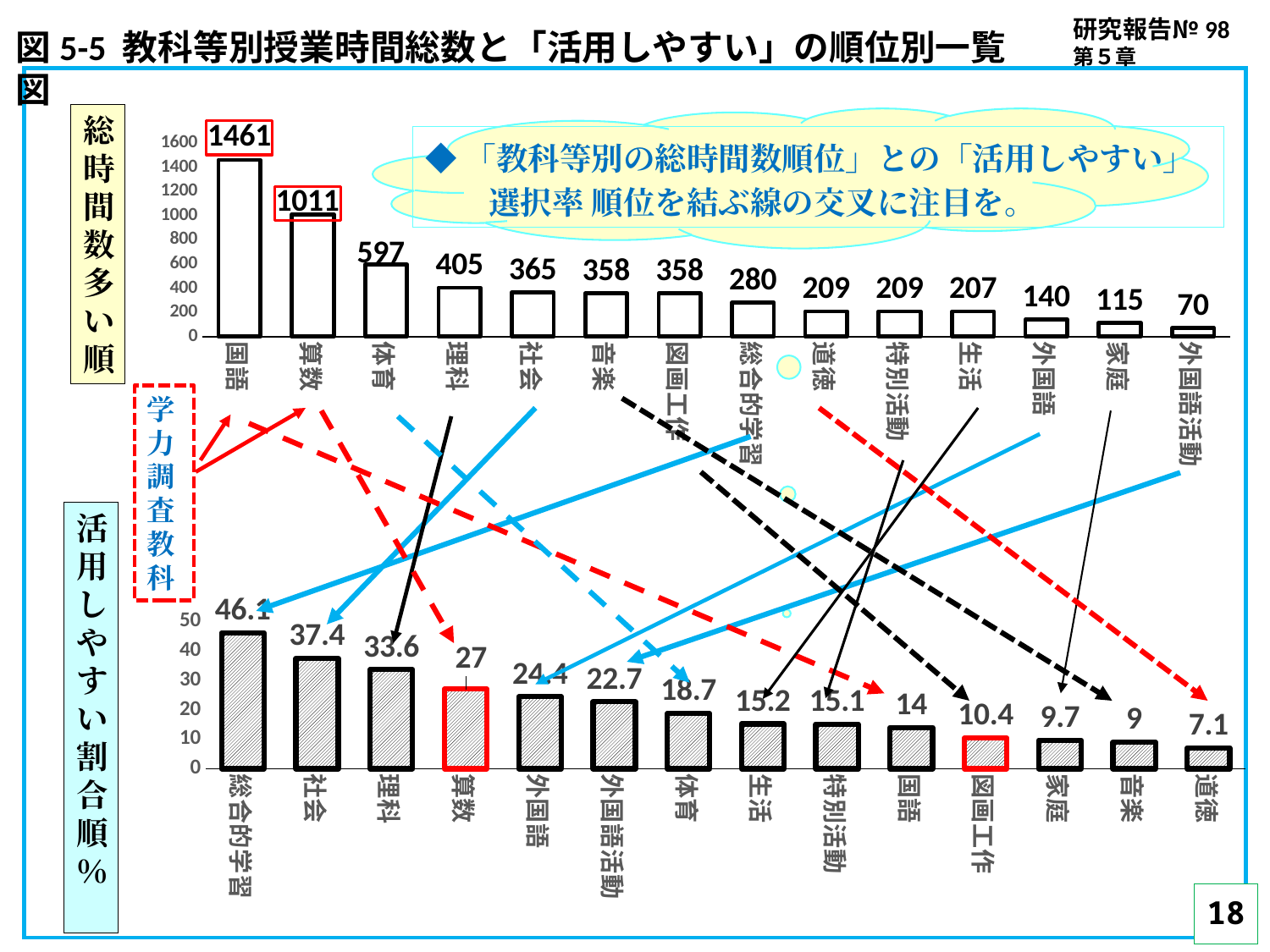
In the top chart (総時間数多い順), what is the value for 理科? 405 In the bottom chart (活用しやすい割合順%), which category has the highest value? 総合的学習 What kind of chart is the top chart (総時間数多い順)? bar chart In the bottom chart (活用しやすい割合順%), which is larger, the value for 外国語 or the value for 体育? 外国語 In the bottom chart (活用しやすい割合順%), what is the difference between the values for 総合的学習 and 社会? 8.7 In the bottom chart (活用しやすい割合順%), which category has the lowest value? 道徳 In the top chart (総時間数多い順), what is the difference between the values for 国語 and 算数? 450 In the top chart (総時間数多い順), how many categories are shown? 14 In the top chart (総時間数多い順), what is the value for 国語? 1461 In the top chart (総時間数多い順), which category has the lowest value? 外国語活動 In the bottom chart (活用しやすい割合順%), what is the value for 社会? 37.4 In the bottom chart (活用しやすい割合順%), what is the value for 図画工作? 10.4